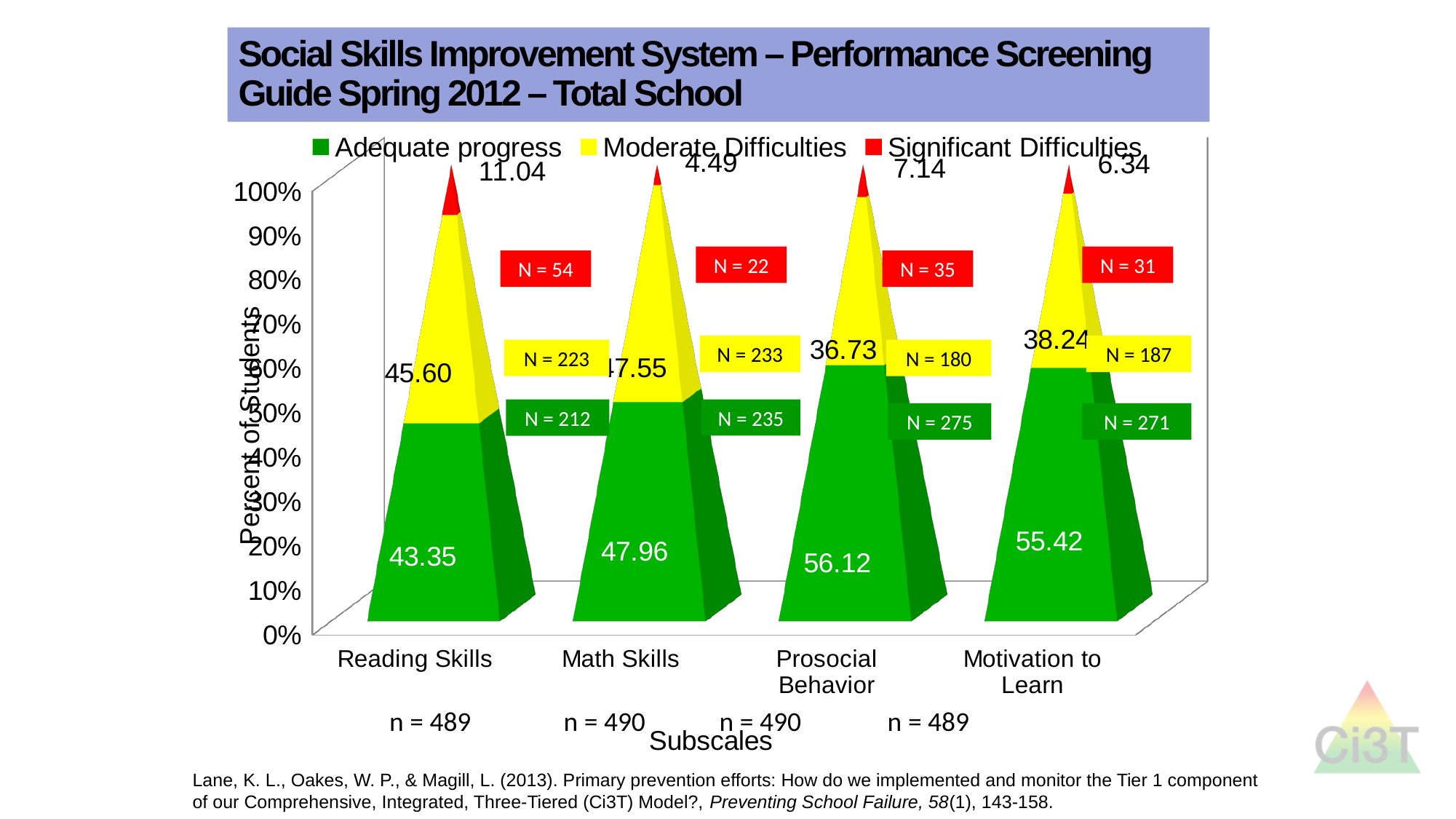
How many students (N) had Significant Difficulties on the Math Skills subscale? N = 22 What kind of chart is shown on the slide? Stacked bar chart Which subscale has the highest Adequate progress percentage? Prosocial Behavior What is the Moderate Difficulties value for Motivation to Learn? 38.24 How many series does the legend list? 3 What is the title of the vertical axis? Percent of Students Which subscale has the lowest Significant Difficulties percentage? Math Skills Which subscale has a larger Moderate Difficulties value, Reading Skills or Motivation to Learn? Reading Skills What is the difference between the Significant Difficulties values for Reading Skills and Math Skills? 6.55 What is the Significant Difficulties value for Reading Skills? 11.04 What percentage of students showed Adequate progress on the Prosocial Behavior subscale? 56.12 How many subscales are shown on the x axis? 4